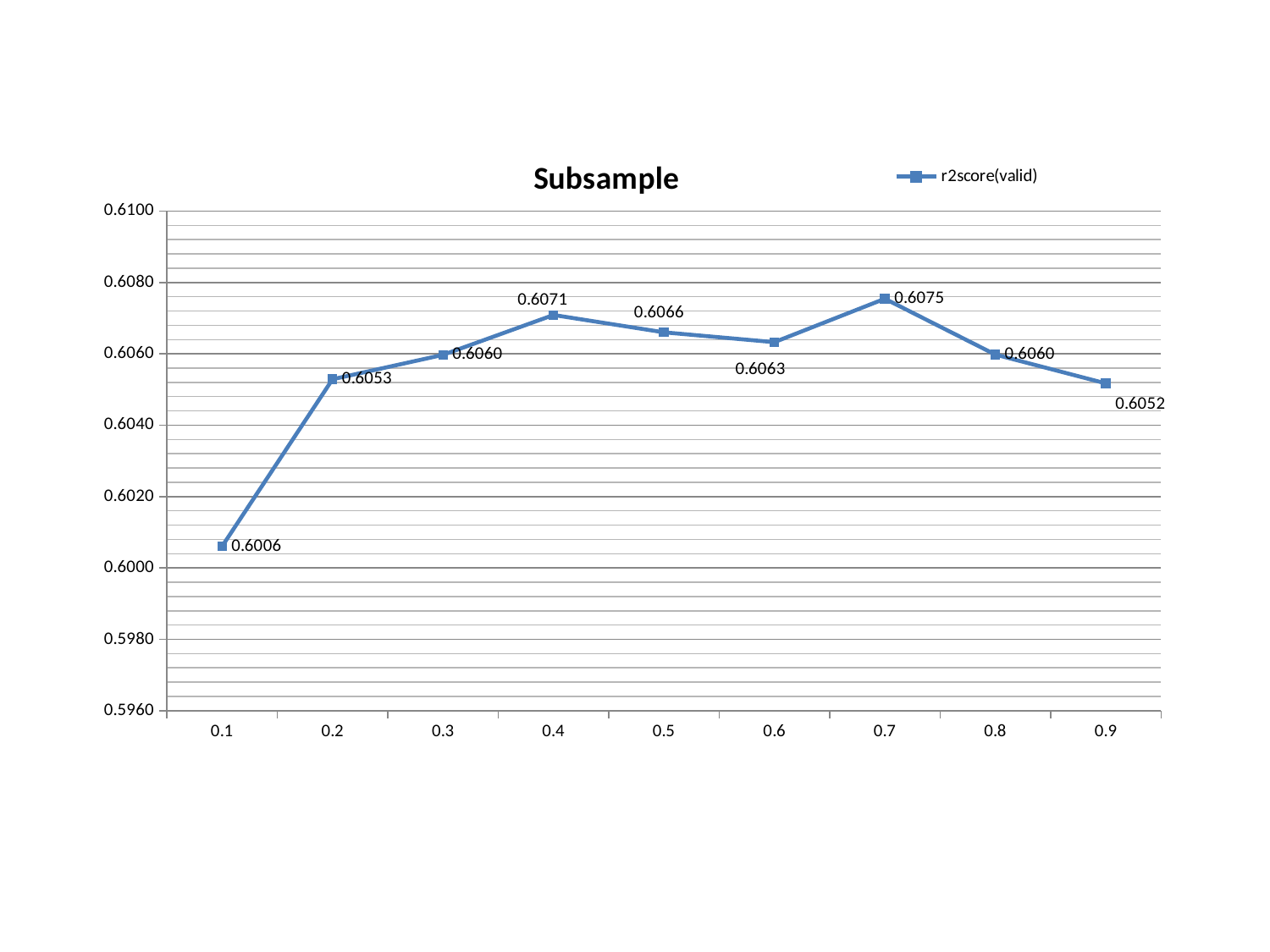
What is the r2score(valid) value at subsample 0.9? 0.6052 What is the r2score(valid) value at subsample 0.4? 0.6071 At which subsample value is r2score(valid) lowest? 0.1 What is the title of the chart? Subsample What kind of chart is shown on the slide? line chart What is the r2score(valid) value at subsample 0.1? 0.6006 How many subsample values are plotted on the chart? 9 Is the r2score(valid) value at subsample 0.1 greater or less than 0.6020? less Which has a higher r2score(valid): subsample 0.4 or subsample 0.6? 0.4 How many series does the legend list? 1 What is the difference between the r2score(valid) at subsample 0.7 and at subsample 0.1? 0.0069 At which subsample value is r2score(valid) highest? 0.7